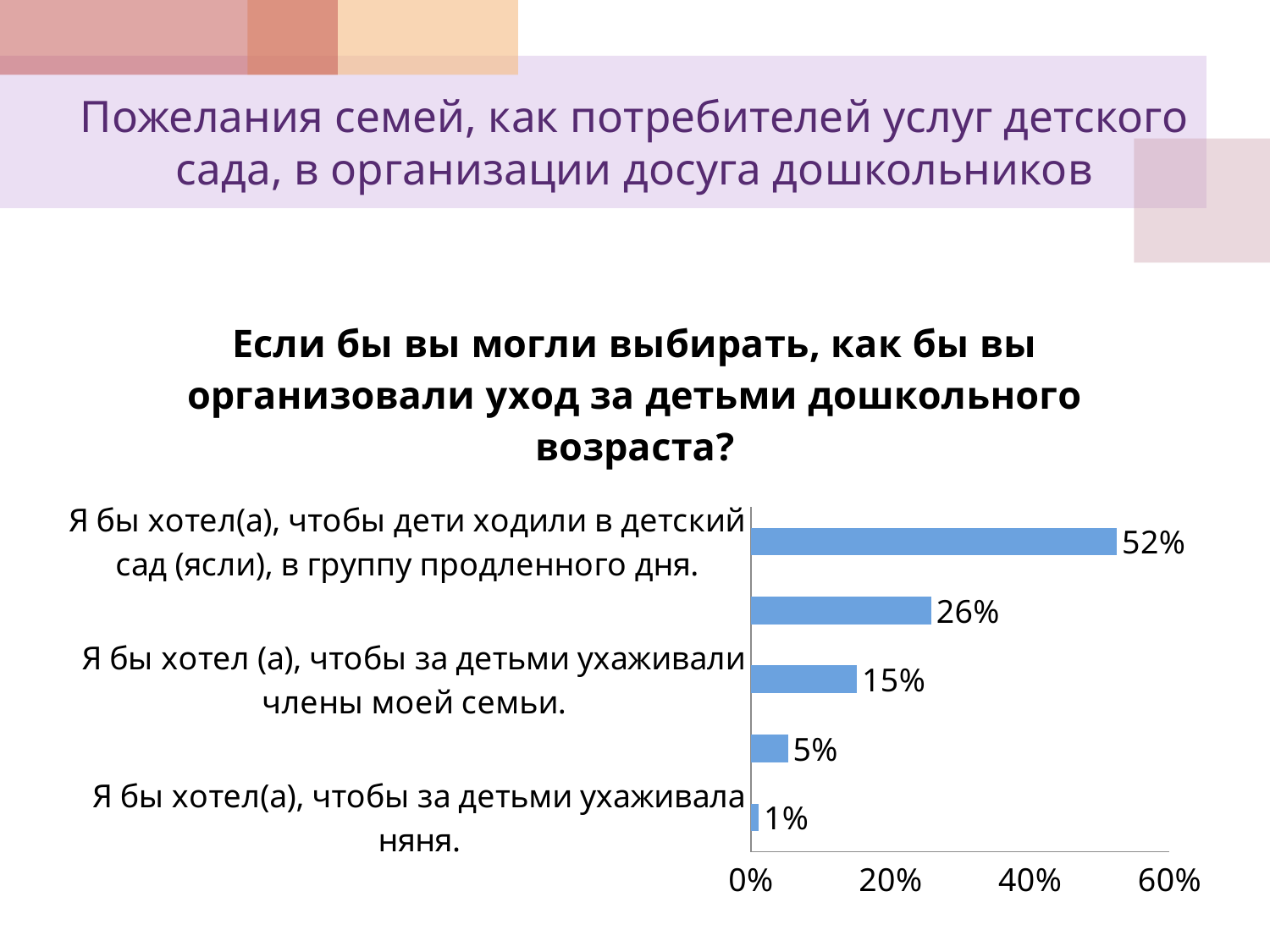
What kind of chart is shown on the slide? bar chart What is the difference between the value for "Я бы хотел(а), чтобы дети ходили в детский сад (ясли), в группу продленного дня." and the value for "Я бы хотел (а), чтобы за детьми ухаживали члены моей семьи."? 37% What is the value for "Я бы хотел (а), чтобы за детьми ухаживали члены моей семьи."? 15% What is the value for "Я бы хотел(а), чтобы за детьми ухаживала няня."? 1% Which is larger: the value for "Я бы хотел (а), чтобы за детьми ухаживали члены моей семьи." or the value for "Я бы хотел(а), чтобы за детьми ухаживала няня."? Я бы хотел (а), чтобы за детьми ухаживали члены моей семьи. How many bars are plotted in the chart? 5 What is the highest value shown on the chart's horizontal axis? 60% What is the title of the chart? Если бы вы могли выбирать, как бы вы организовали уход за детьми дошкольного возраста? What is the value for "Я бы хотел(а), чтобы дети ходили в детский сад (ясли), в группу продленного дня."? 52% Which category has the lowest value? Я бы хотел(а), чтобы за детьми ухаживала няня. Which category has the highest value? Я бы хотел(а), чтобы дети ходили в детский сад (ясли), в группу продленного дня. Is the value for "Я бы хотел(а), чтобы дети ходили в детский сад (ясли), в группу продленного дня." greater or less than 40%? greater